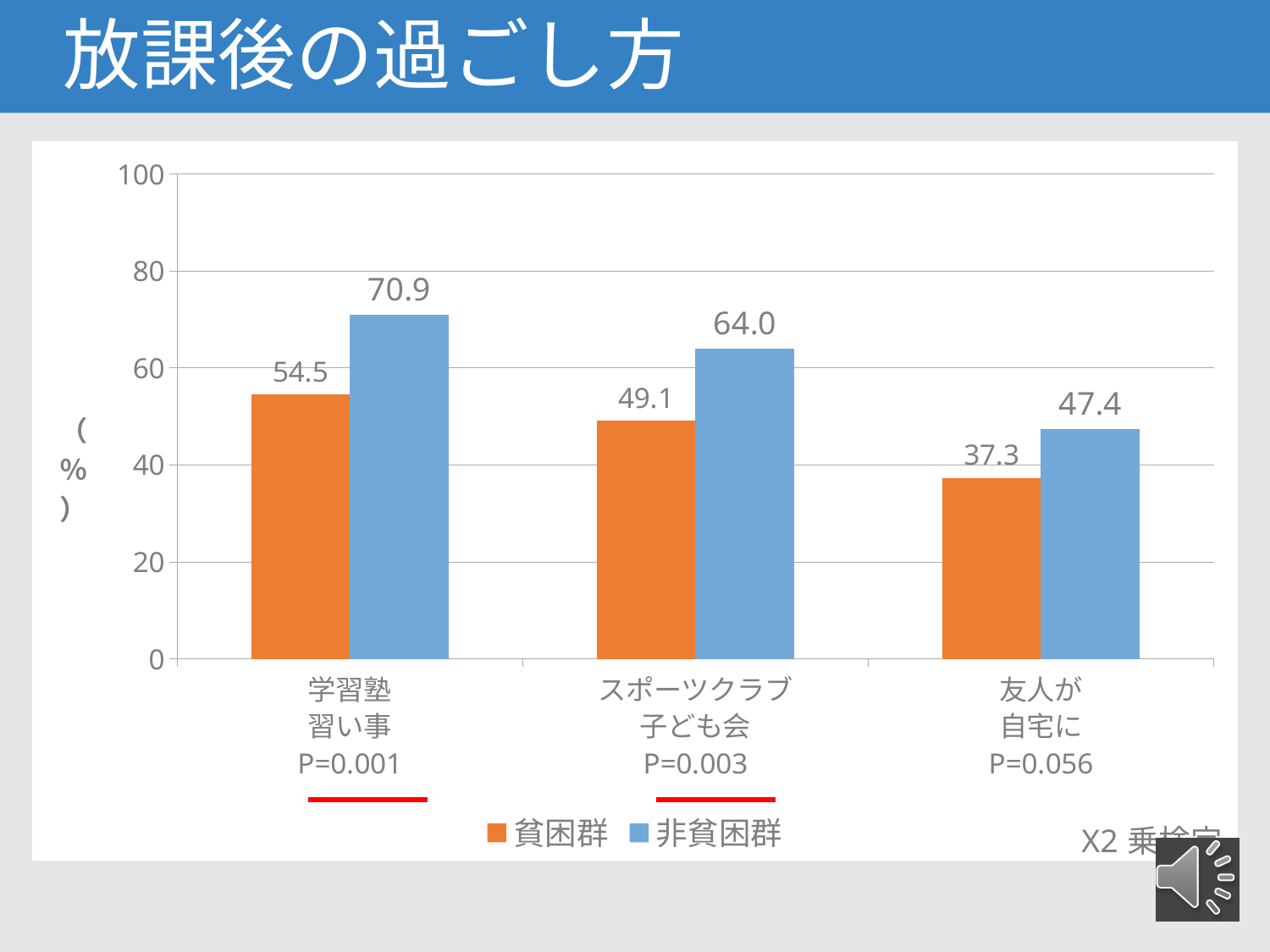
Which category has the highest value for 非貧困群? 学習塾・習い事 What kind of chart is shown on the slide? bar chart What is the P value shown under the 友人が自宅に category? P=0.056 What is the value for 貧困群 in the 学習塾・習い事 category? 54.5 What is the value for 貧困群 in the 友人が自宅に category? 37.3 Which category has the lowest value for 貧困群? 友人が自宅に What is the difference between 非貧困群 and 貧困群 in the 学習塾・習い事 category? 16.4 How many categories are shown on the x axis? 3 How many series does the legend list? 2 What is the value for 非貧困群 in the スポーツクラブ・子ども会 category? 64.0 What is the difference between 非貧困群 and 貧困群 in the 友人が自宅に category? 10.1 Which is larger in the スポーツクラブ・子ども会 category, 貧困群 or 非貧困群? 非貧困群